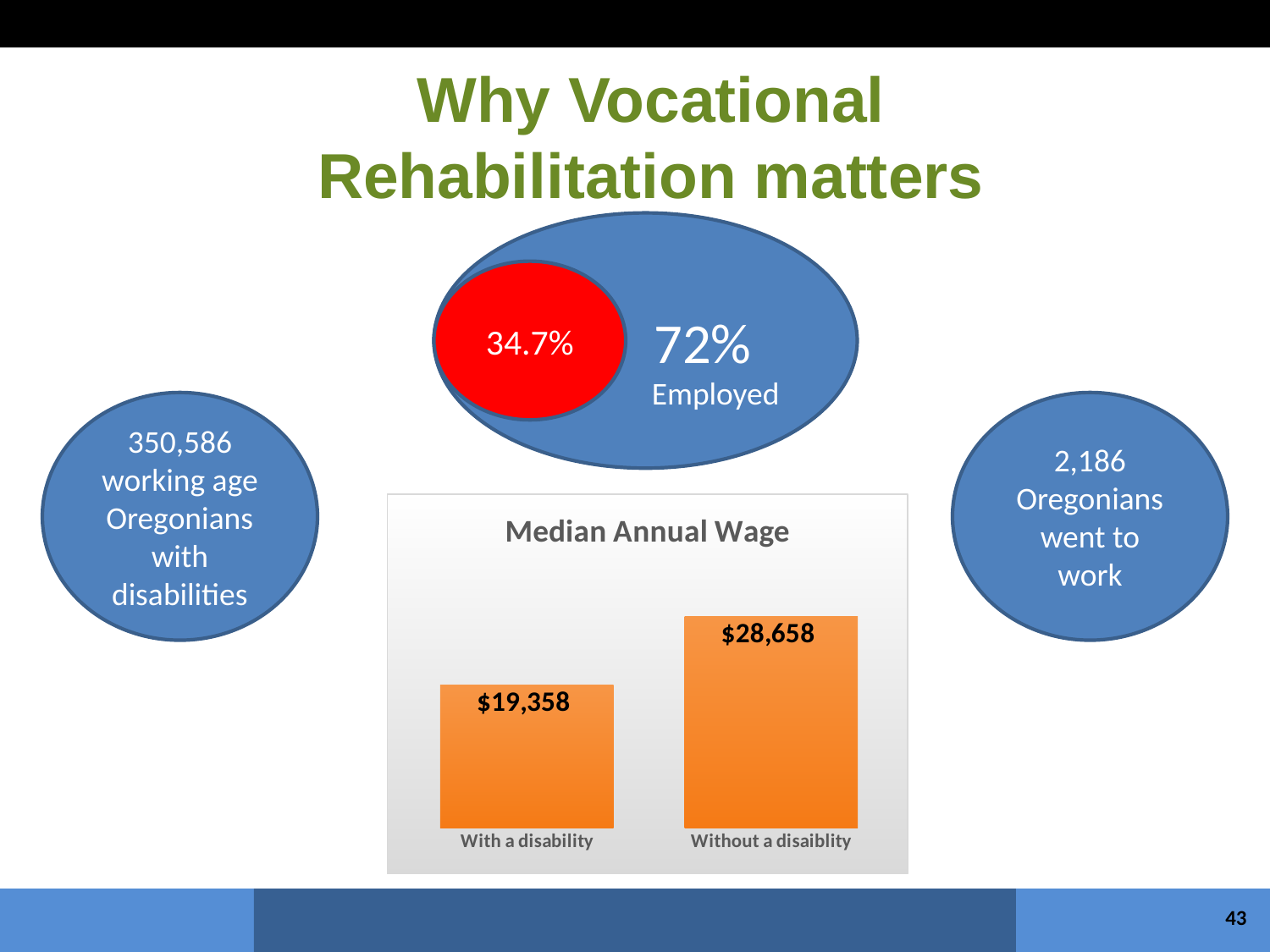
How many categories are shown in the Median Annual Wage chart? 2 Is the median annual wage higher for people with a disability or for people without a disability? Without a disability What is the median annual wage for people without a disability? $28,658 What kind of chart is the Median Annual Wage chart? Bar chart What is the difference in median annual wage between people without a disability and people with a disability? $9,300 Which category has the lower median annual wage? With a disability What is the median annual wage for people with a disability? $19,358 What is the title of the chart on the slide? Median Annual Wage What colour are the bars in the Median Annual Wage chart? Orange Which category has the higher median annual wage? Without a disaiblity